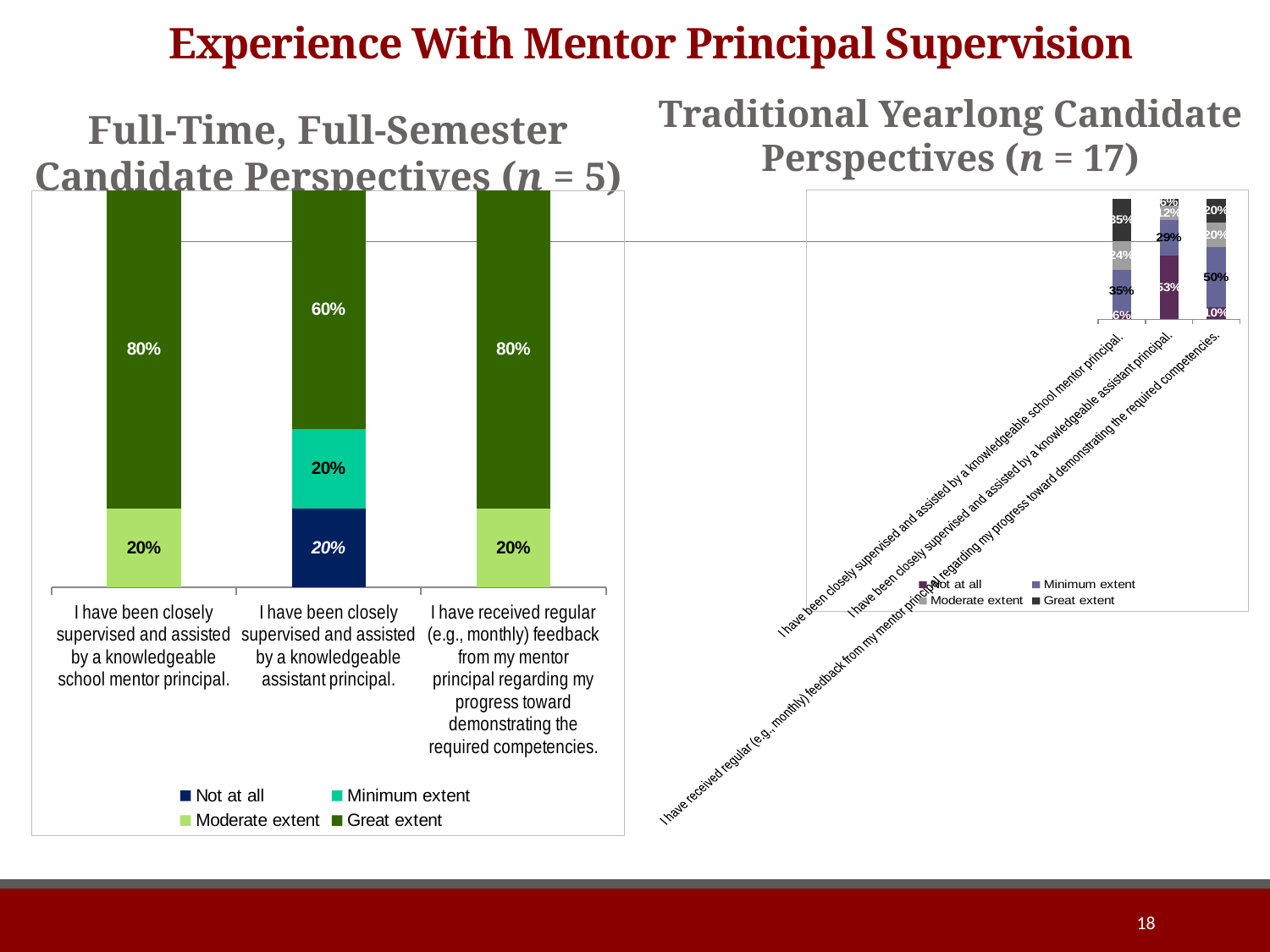
In the Full-Time, Full-Semester Candidate Perspectives chart, what percentage reported 'Not at all' for being closely supervised and assisted by a knowledgeable assistant principal? 20% In the Full-Time, Full-Semester Candidate Perspectives chart, how many categories are shown on the x axis? 3 In the Full-Time, Full-Semester Candidate Perspectives chart, what percentage of candidates reported 'Great extent' for being closely supervised and assisted by a knowledgeable school mentor principal? 80% In the Full-Time, Full-Semester Candidate Perspectives chart, which item has the lowest 'Great extent' percentage? I have been closely supervised and assisted by a knowledgeable assistant principal. What is the sample size (n) shown in the title of the Traditional Yearlong Candidate Perspectives chart? 17 In the Full-Time, Full-Semester Candidate Perspectives chart, what percentage reported 'Great extent' for being closely supervised and assisted by a knowledgeable assistant principal? 60% In the Full-Time, Full-Semester Candidate Perspectives chart, how many series does the legend list? 4 What kind of chart is the Full-Time, Full-Semester Candidate Perspectives chart? Stacked bar chart In the Full-Time, Full-Semester Candidate Perspectives chart, what is the difference between the 'Great extent' value for the school mentor principal item and the 'Great extent' value for the assistant principal item? 20% In the Full-Time, Full-Semester Candidate Perspectives chart, what percentage reported 'Moderate extent' for receiving regular feedback from their mentor principal? 20% In the Traditional Yearlong Candidate Perspectives chart, what percentage reported 'Not at all' for being closely supervised and assisted by a knowledgeable assistant principal? 53% In the Traditional Yearlong Candidate Perspectives chart, what percentage reported 'Minimum extent' for receiving regular feedback from their mentor principal? 50%